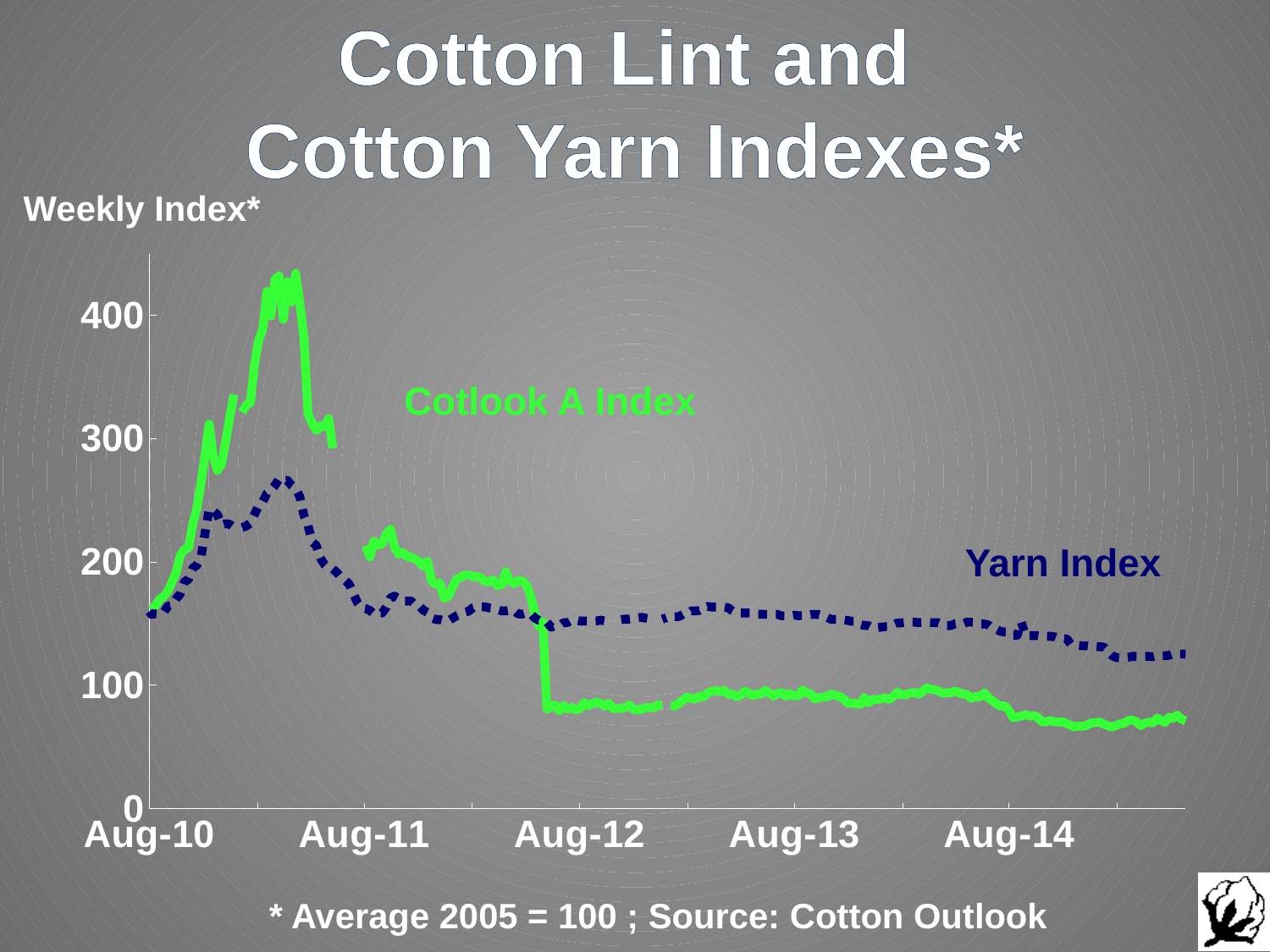
At Aug-11, which series is higher, the Cotlook A Index or the Yarn Index? Cotlook A Index Which series reaches the highest value on the chart? Cotlook A Index Is the peak value of the Yarn Index greater or less than 300? less Is the value of the Cotlook A Index at Aug-14 greater or less than 100? less Is the value of the Yarn Index at Aug-12 greater or less than 200? less How many series are plotted on the chart? 2 Does the Yarn Index rise or fall between Aug-13 and the end of the series? fall What kind of chart is shown on the slide? line chart What is the title of the chart? Cotton Lint and Cotton Yarn Indexes* At Aug-14, which series is higher, the Yarn Index or the Cotlook A Index? Yarn Index How many year labels are shown on the x axis? 5